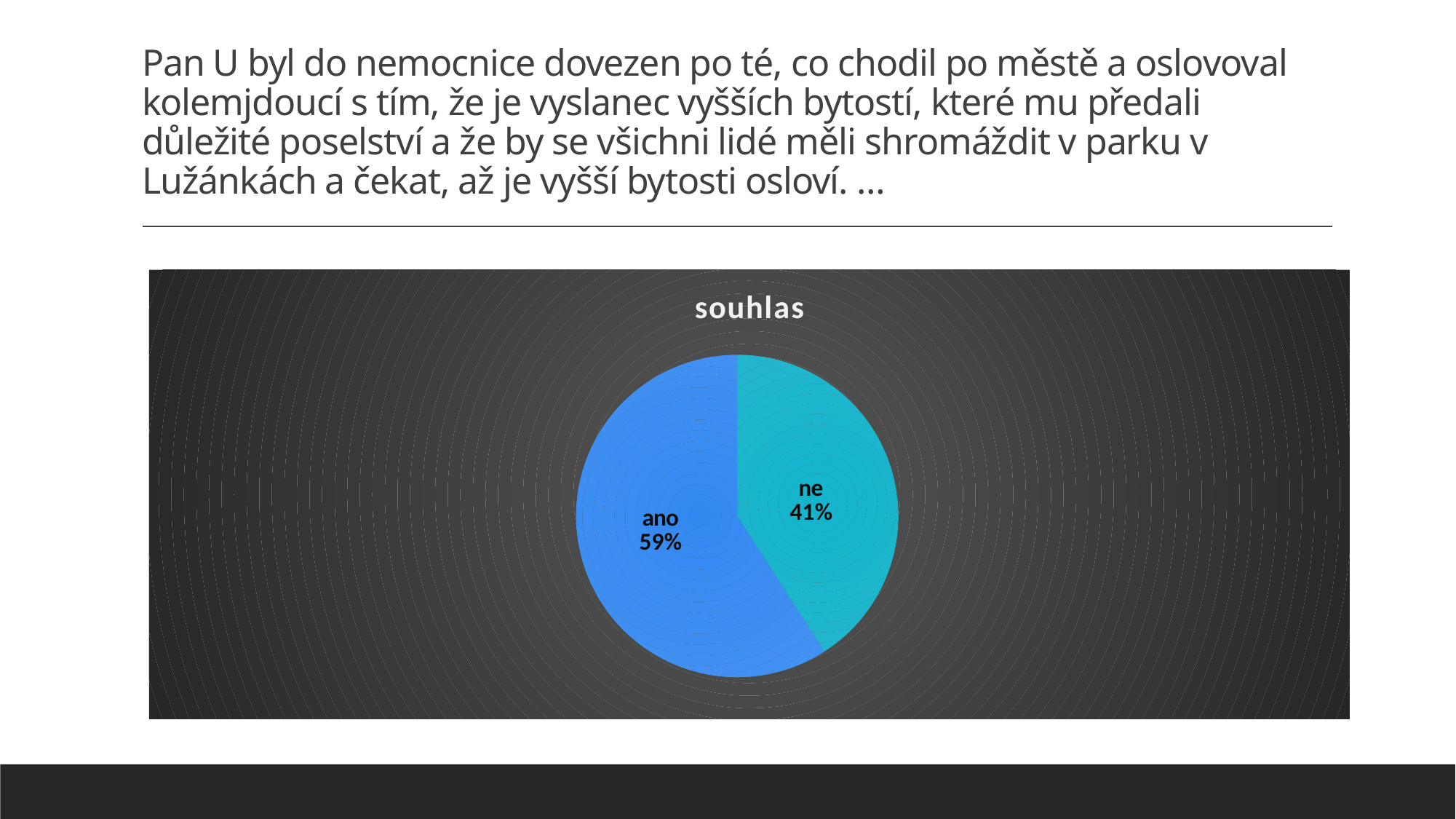
How many slices does the pie chart have? 2 What colour is the "ano" slice? blue Is the value for "ne" greater or less than 50%? less Which is larger, the "ano" slice or the "ne" slice? ano What is the title of the chart? souhlas Which slice is the smallest in the pie chart? ne What share of the pie does the "ano" slice represent? 59% What kind of chart is shown on the slide? pie chart Which slice is the largest in the pie chart? ano What is the difference in percentage points between the "ano" and "ne" slices? 18 What share of the pie does the "ne" slice represent? 41%